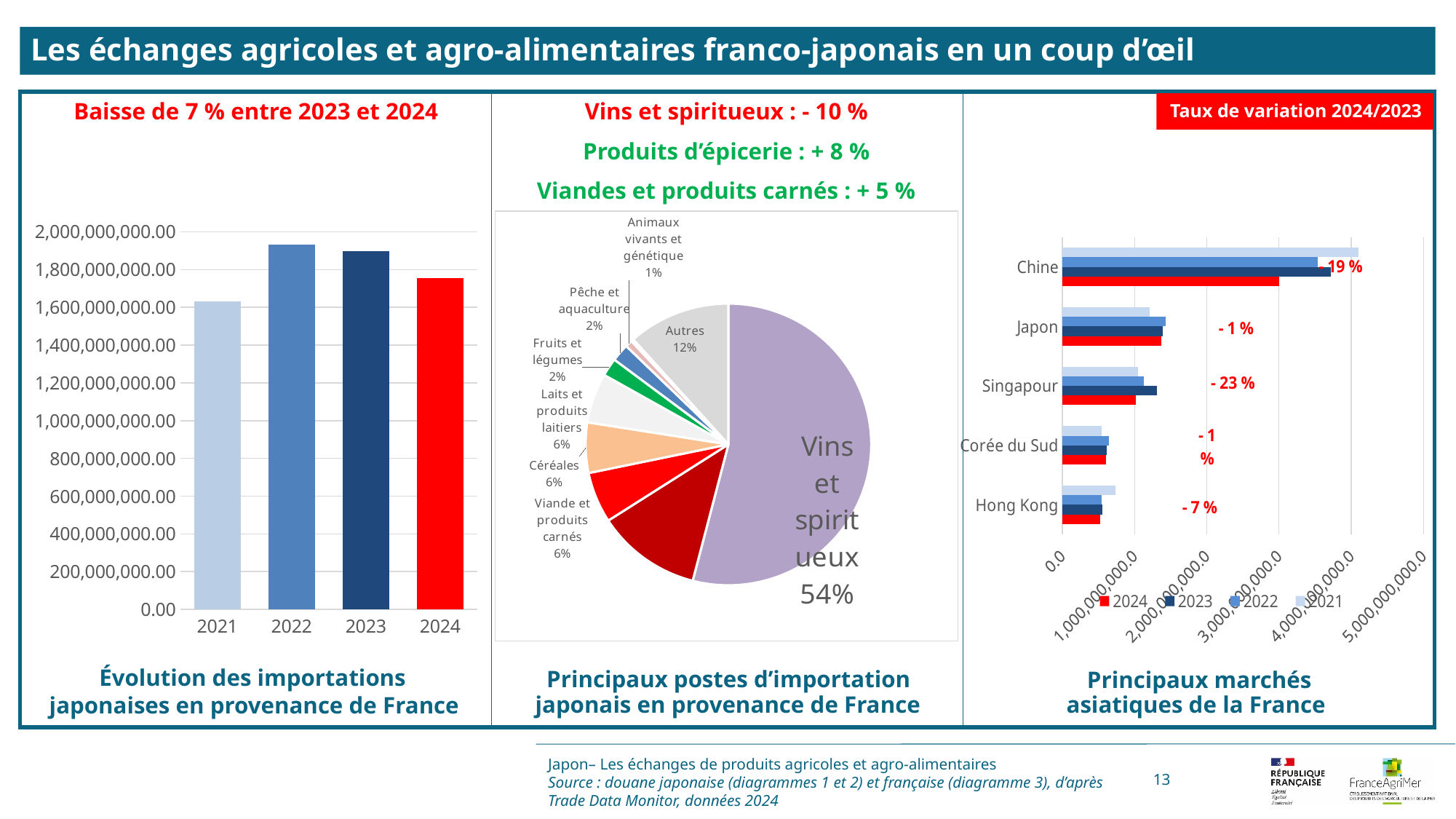
In the right chart 'Principaux marchés asiatiques de la France', how many markets are plotted? 5 In the left chart 'Évolution des importations japonaises en provenance de France', how many years are plotted? 4 In the right chart 'Principaux marchés asiatiques de la France', how many series does the legend list? 4 In the left chart 'Évolution des importations japonaises en provenance de France', do the values rise or fall from 2022 to 2024? fall In the middle pie chart 'Principaux postes d'importation japonais en provenance de France', which slice is the largest? Vins et spiritueux In the right chart 'Principaux marchés asiatiques de la France', is the 2024 value for Chine greater or less than 2,000,000,000.0? greater What kind of chart is the left chart, 'Évolution des importations japonaises en provenance de France'? bar chart In the left chart 'Évolution des importations japonaises en provenance de France', which year has the lowest value? 2021 In the middle pie chart 'Principaux postes d'importation japonais en provenance de France', what share does 'Autres' represent? 12% In the left chart 'Évolution des importations japonaises en provenance de France', is the value for 2024 greater or less than 1,800,000,000.00? less In the middle pie chart 'Principaux postes d'importation japonais en provenance de France', what share does 'Vins et spiritueux' represent? 54% In the right chart 'Principaux marchés asiatiques de la France', what is the 2024/2023 variation rate shown for Singapour? - 23 %